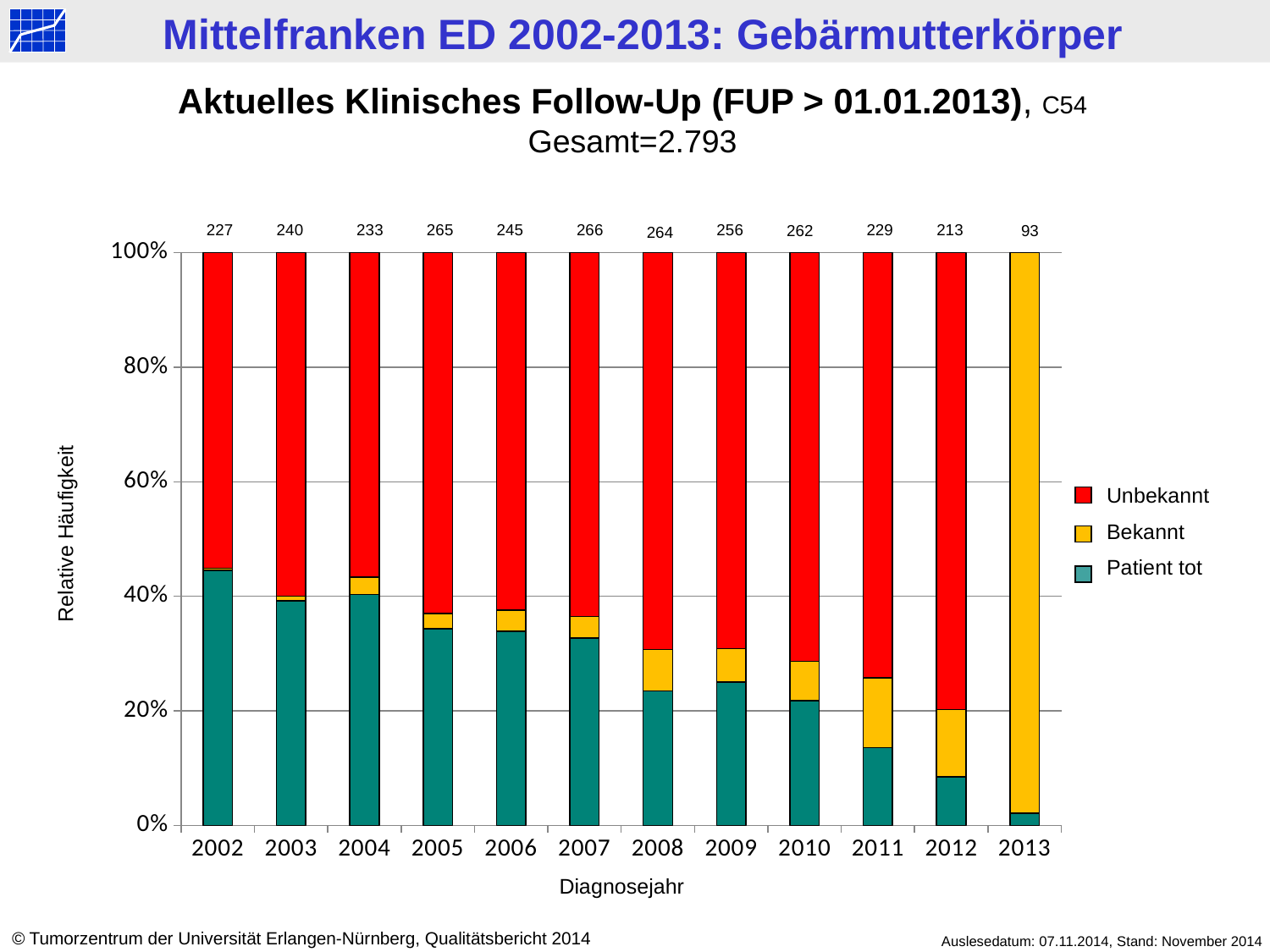
Which diagnosis year has the lowest number printed above its bar? 2013 Is the 'Patient tot' share for 2002 greater or less than 40%? greater Is the 'Patient tot' share for 2012 greater or less than 20%? less What number is printed above the bar for 2013? 93 Which diagnosis year has the highest number printed above its bar? 2007 How many series does the legend list? 3 What is the difference between the numbers printed above the bars for 2007 and 2013? 173 How many diagnosis years are shown on the x axis? 12 Which has the larger number printed above its bar, 2003 or 2011? 2003 What number is printed above the bar for 2002? 227 What number is printed above the bar for 2007? 266 What kind of chart is shown on the slide? Stacked bar chart